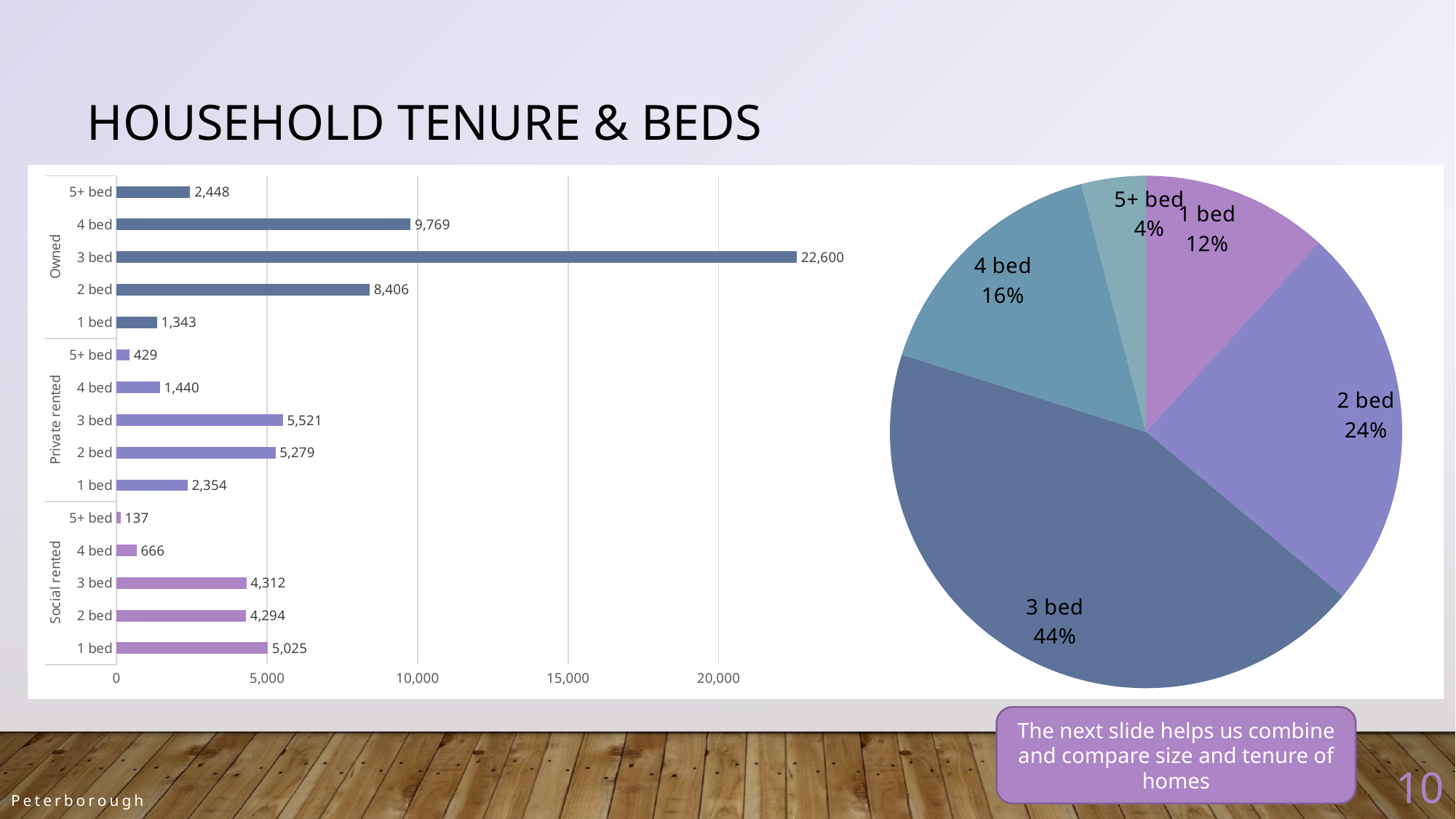
In the bar chart on the left, what are the three tenure groups shown on the vertical axis? Owned, Private rented, Social rented How many bars are shown in the bar chart on the left? 15 In the bar chart on the left, which is larger in the Owned group: 4 bed or 2 bed? 4 bed In the pie chart on the right, which category has the smallest slice? 5+ bed In the bar chart on the left, which bar has the highest value? Owned, 3 bed In the bar chart on the left, what is the difference between the 3 bed and 2 bed values in the Private rented group? 242 In the bar chart on the left, what is the value for 1 bed homes in the Social rented group? 5,025 What kind of chart is the chart on the left of the slide? Bar chart In the bar chart on the left, what is the value for 3 bed homes in the Owned group? 22,600 In the bar chart on the left, is the value for Owned 3 bed greater or less than 20,000? greater In the bar chart on the left, which bar has the lowest value? Social rented, 5+ bed In the pie chart on the right, what share do 3 bed homes have? 44%